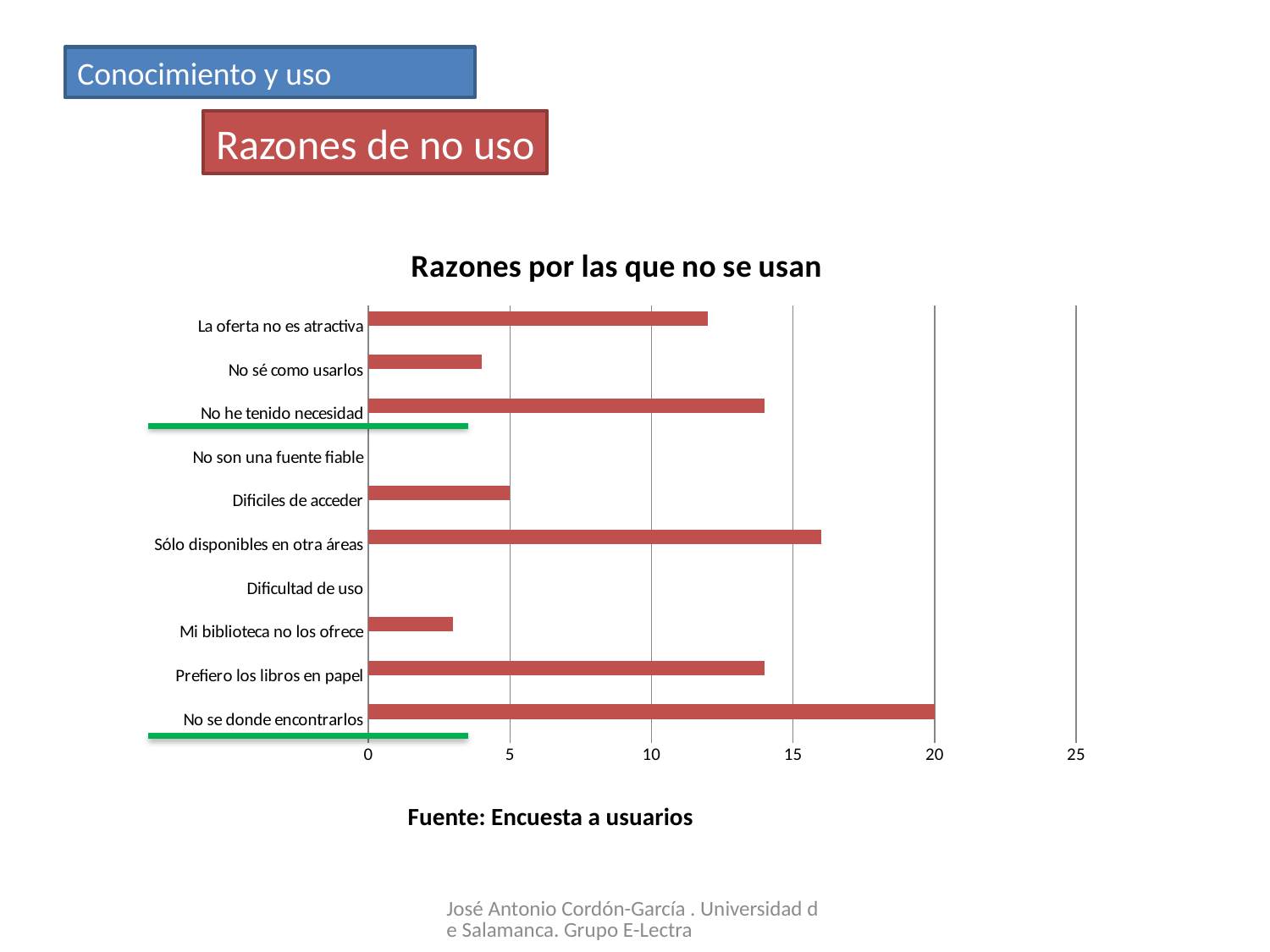
What is the value for "No se donde encontrarlos"? 20 What source is cited below the chart? Fuente: Encuesta a usuarios Is the value for "Mi biblioteca no los ofrece" greater or less than 5? less Which category has the highest value? No se donde encontrarlos Is the value for "Sólo disponibles en otra áreas" greater or less than 15? greater What kind of chart is shown on the slide? bar chart Is the value for "No sé como usarlos" greater or less than 5? less Which is larger, the value for "Sólo disponibles en otra áreas" or the value for "La oferta no es atractiva"? Sólo disponibles en otra áreas What is the title of the chart? Razones por las que no se usan How many categories are plotted in the chart? 10 What is the value for "Dificiles de acceder"? 5